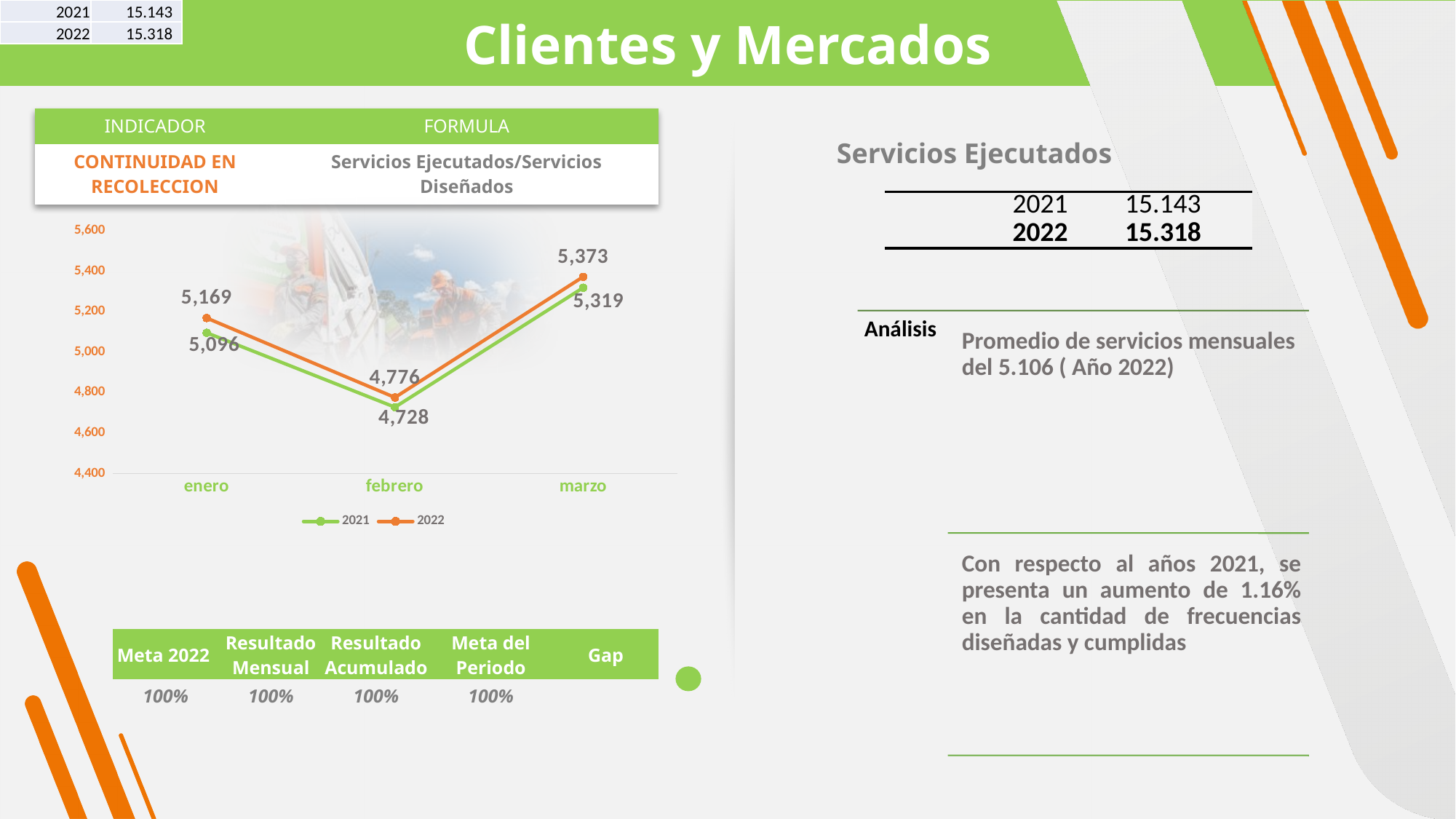
What is the value for 2022 in enero? 5,169 What is the value for 2021 in febrero? 4,728 Does the 2021 series rise or fall from enero to febrero? fall Which colour is used for the 2022 series in the chart? orange In which month is the 2021 series lowest? febrero What type of chart is shown on the slide? line chart How many months are plotted on the x axis of the chart? 3 What is the difference between the 2022 and 2021 values in marzo? 54 Which series has the larger value in febrero, 2021 or 2022? 2022 In which month is the 2022 series highest? marzo How many series does the chart legend list? 2 What is the value for 2022 in marzo? 5,373